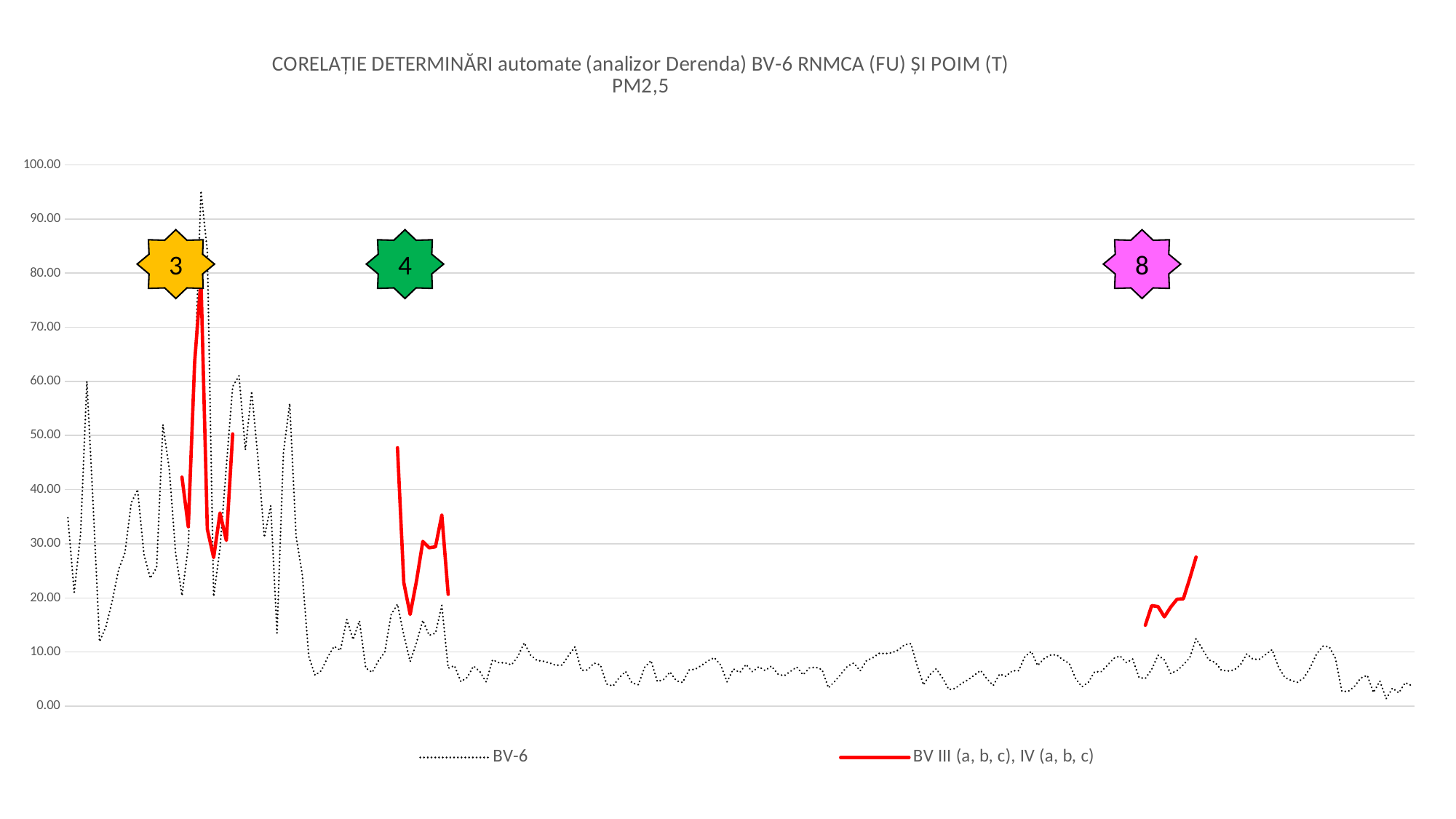
Which series is drawn as a dotted black line? BV-6 Which series is drawn as a solid red line? BV III (a, b, c), IV (a, b, c) Is the highest value of the BV III (a, b, c), IV (a, b, c) series greater or less than 80.00? less In the right-hand part of the chart, are the BV-6 values mostly greater or less than 20.00? less What is the highest value shown on the vertical axis? 100.00 Is the highest value of the BV-6 series greater or less than 90.00? greater How many series does the legend list? 2 What kind of chart is shown on the slide? line chart Do the BV-6 values generally rise or fall from left to right along the x axis? fall Which series reaches the higher peak value, BV-6 or BV III (a, b, c), IV (a, b, c)? BV-6